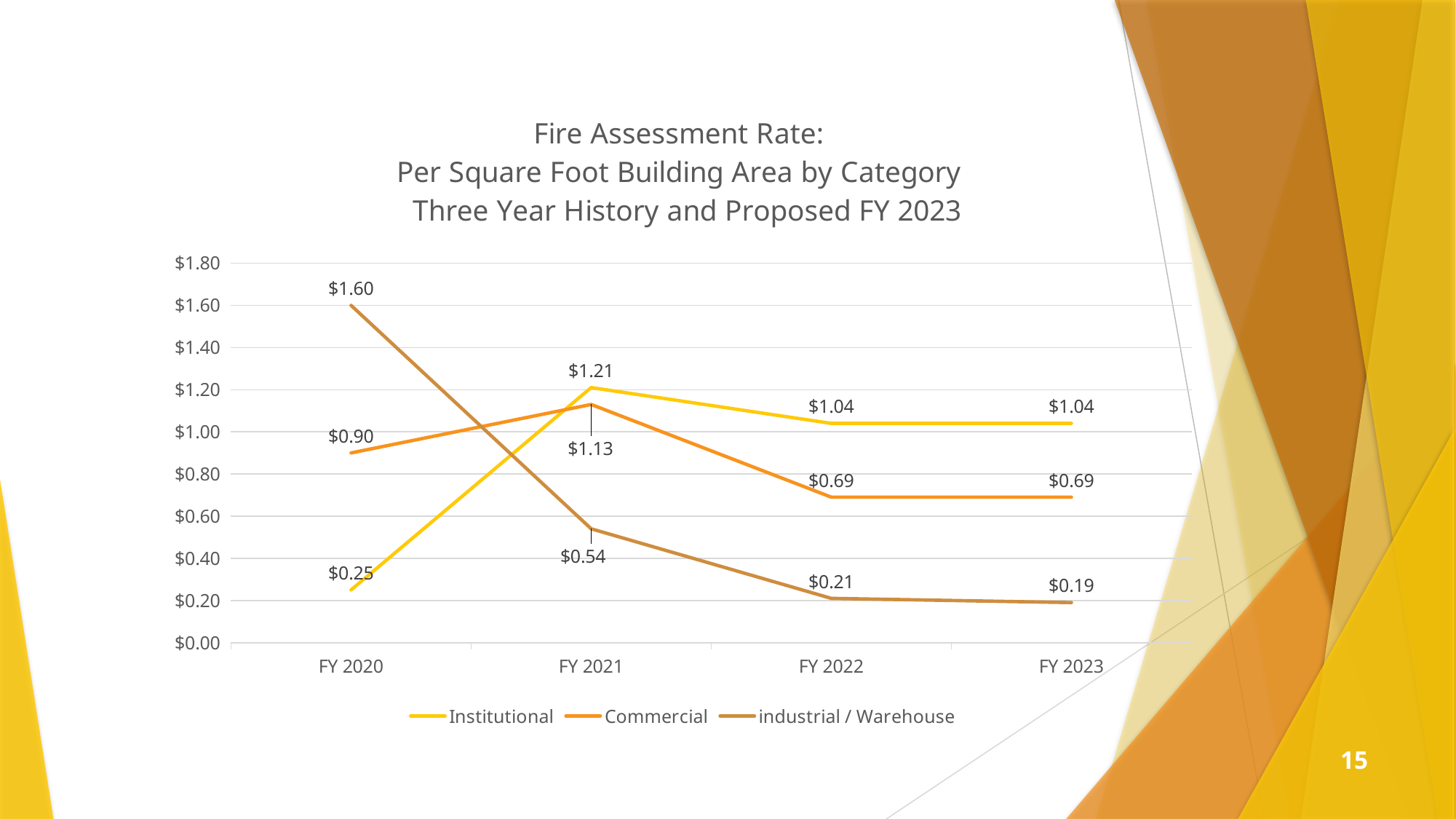
Which series has the lowest value in FY 2022? industrial / Warehouse How many series does the legend list? 3 Does the industrial / Warehouse rate rise or fall from FY 2020 to FY 2023? fall What is the Commercial rate in FY 2020? $0.90 What is the industrial / Warehouse rate in FY 2023? $0.19 What is the Institutional rate in FY 2021? $1.21 Is the Commercial rate in FY 2022 greater or less than $0.80? less Which series has the highest value in FY 2020? industrial / Warehouse What kind of chart is shown on the slide? line chart What is the difference between the industrial / Warehouse rate in FY 2020 and FY 2021? $1.06 How many fiscal years are shown on the x axis? 4 Which is larger in FY 2021, the Institutional rate or the Commercial rate? Institutional